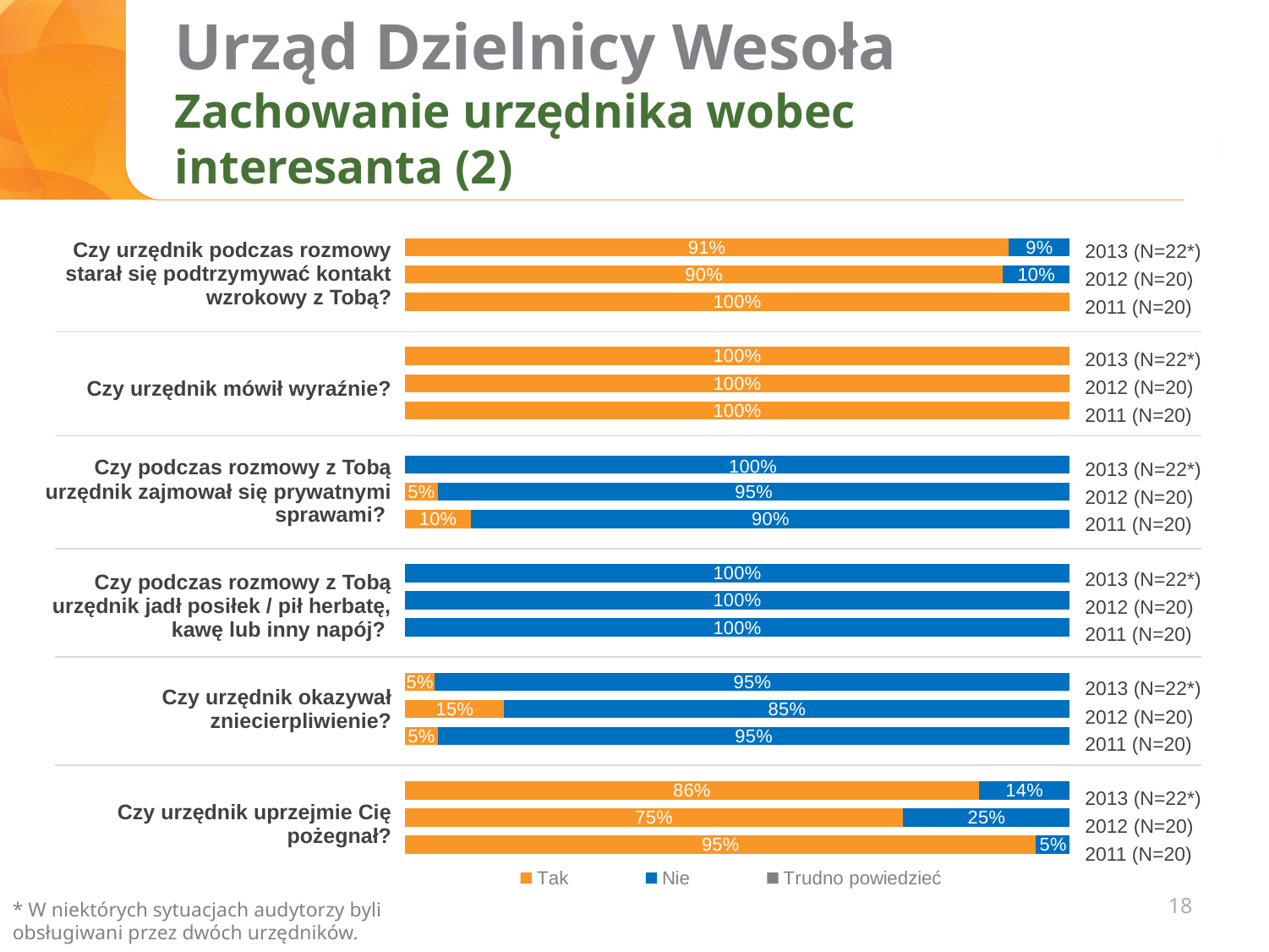
How many series does the legend list? 3 What is the sample size (N) shown for 2013? N=22* What kind of chart is shown on the slide? Stacked bar chart What are the legend entries of the chart? Tak, Nie, Trudno powiedzieć What percentage answered "Tak" in 2012 for "Czy urzędnik uprzejmie Cię pożegnał?"? 75% What percentage answered "Tak" in 2011 for "Czy podczas rozmowy z Tobą urzędnik zajmował się prywatnymi sprawami?"? 10% For "Czy urzędnik uprzejmie Cię pożegnał?", which year had the highest "Tak" share? 2011 What percentage answered "Tak" in 2012 for "Czy urzędnik okazywał zniecierpliwienie?"? 15% For "Czy urzędnik uprzejmie Cię pożegnał?", what is the difference in percentage points between the "Tak" share in 2013 and in 2012? 11 percentage points For "Czy urzędnik uprzejmie Cię pożegnał?", which year had the larger "Nie" share, 2012 or 2013? 2012 What percentage answered "Tak" in 2013 for "Czy urzędnik podczas rozmowy starał się podtrzymywać kontakt wzrokowy z Tobą?"? 91% What percentage answered "Nie" in 2012 for "Czy urzędnik podczas rozmowy starał się podtrzymywać kontakt wzrokowy z Tobą?"? 10%